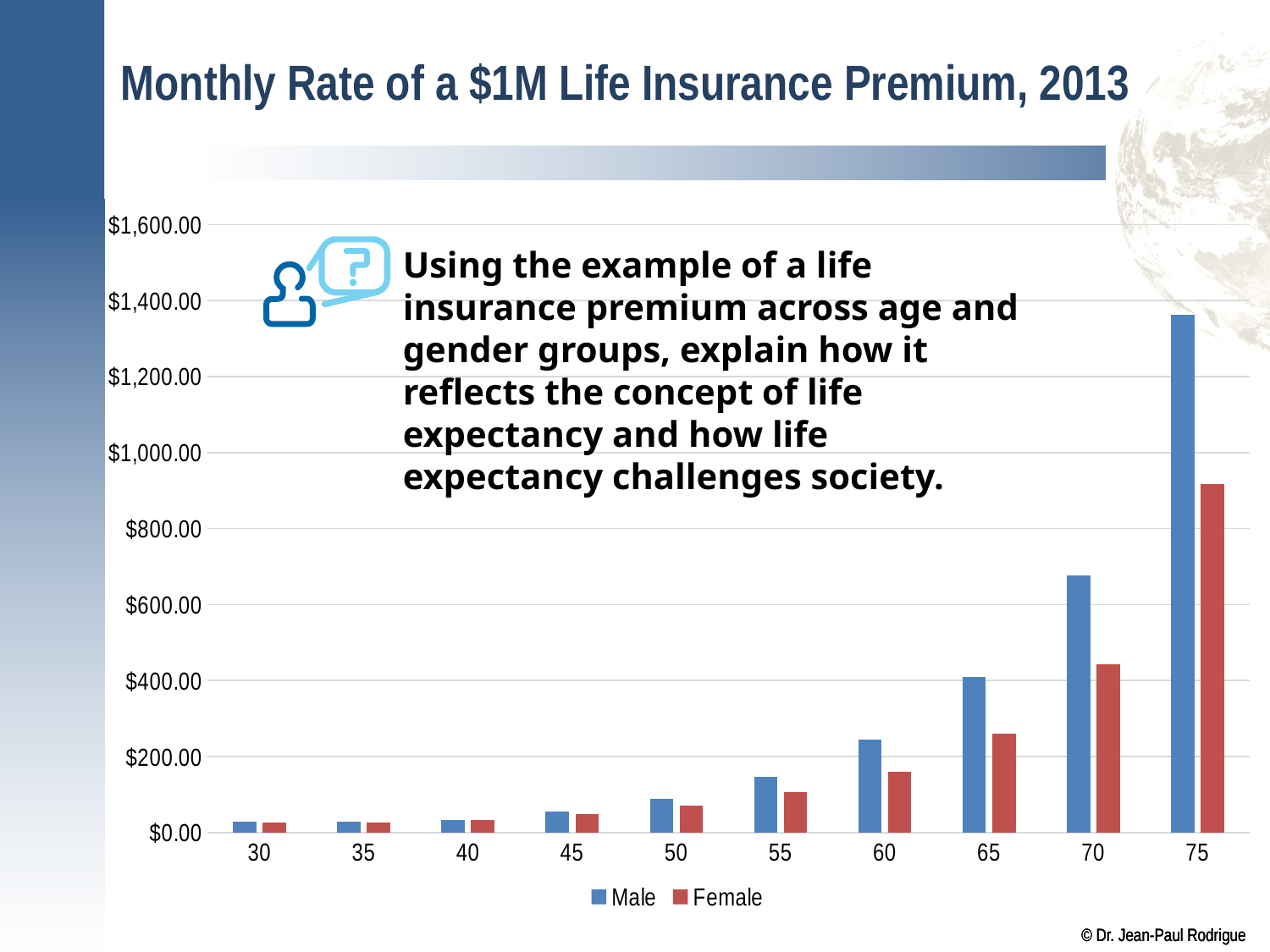
Which age group has the highest Female premium? 75 Which age group has the highest Male premium? 75 What kind of chart is shown on the slide? bar chart How many series does the legend list? 2 At age 75, which is larger, the Male or the Female premium? Male What is the title of the chart? Monthly Rate of a $1M Life Insurance Premium, 2013 Is the Male value at age 70 greater or less than $600.00? greater How many age categories are shown on the x axis? 10 Is the Male value at age 75 greater or less than $1,200.00? greater Do the Male premiums rise or fall as age increases along the x axis? rise Is the Female value at age 75 greater or less than $800.00? greater